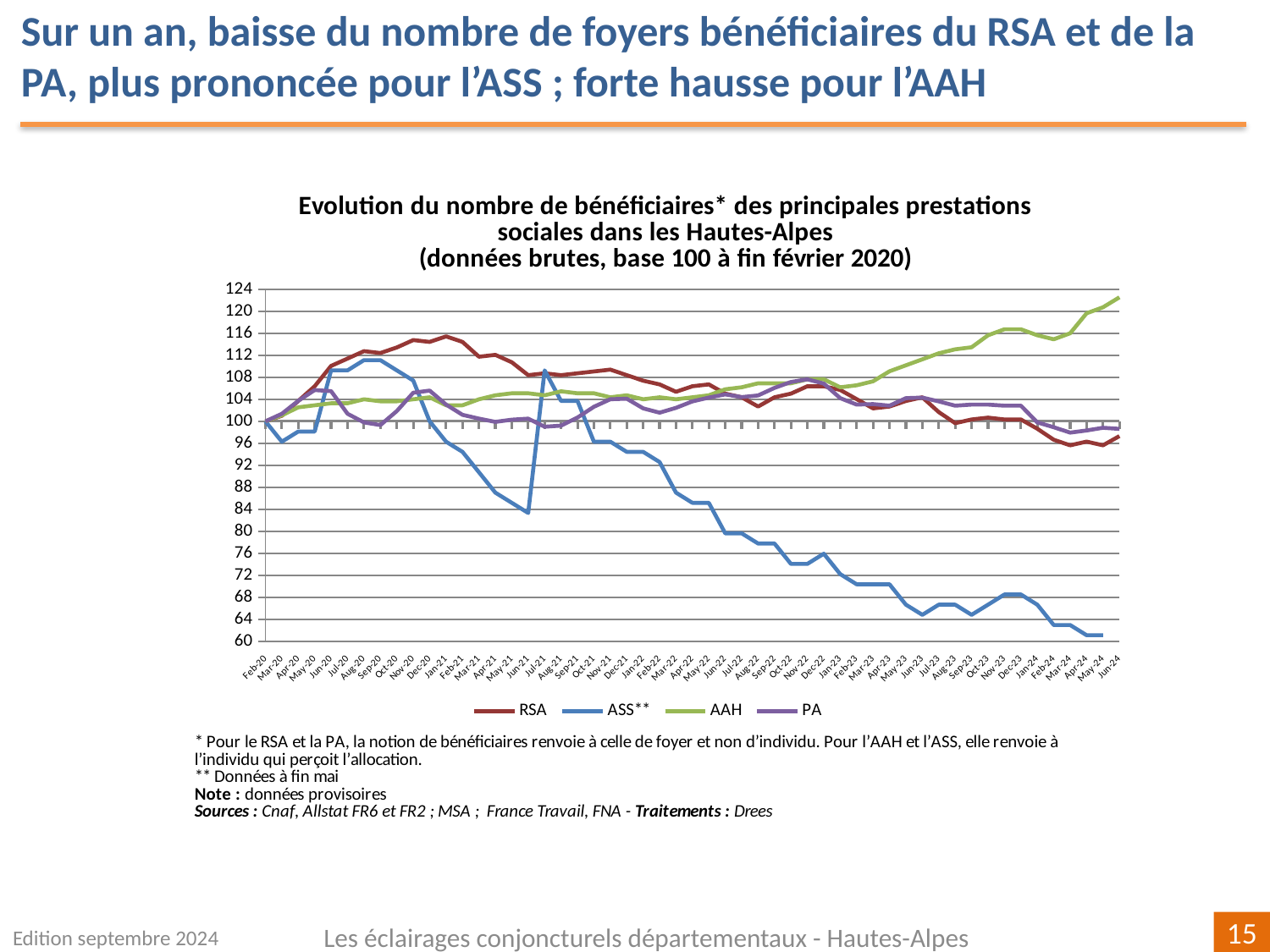
What kind of chart is shown on the slide? line chart Which series has the lowest value at Jun-24? RSA Does the ASS** series overall rise or fall between Feb-20 and Jun-24? fall Which series are listed in the legend? RSA, ASS**, AAH, PA Is the value for RSA at Jun-24 greater or less than 100? less What is the value of all four series at Feb-20, the base month? 100 Is the value for AAH at Jun-24 greater or less than 120? greater How many series does the legend list? 4 Which series has the highest value at Jun-24? AAH Is the value for ASS** at Jun-21 greater or less than 88? less At Jun-24, which is larger: the value for AAH or the value for RSA? AAH